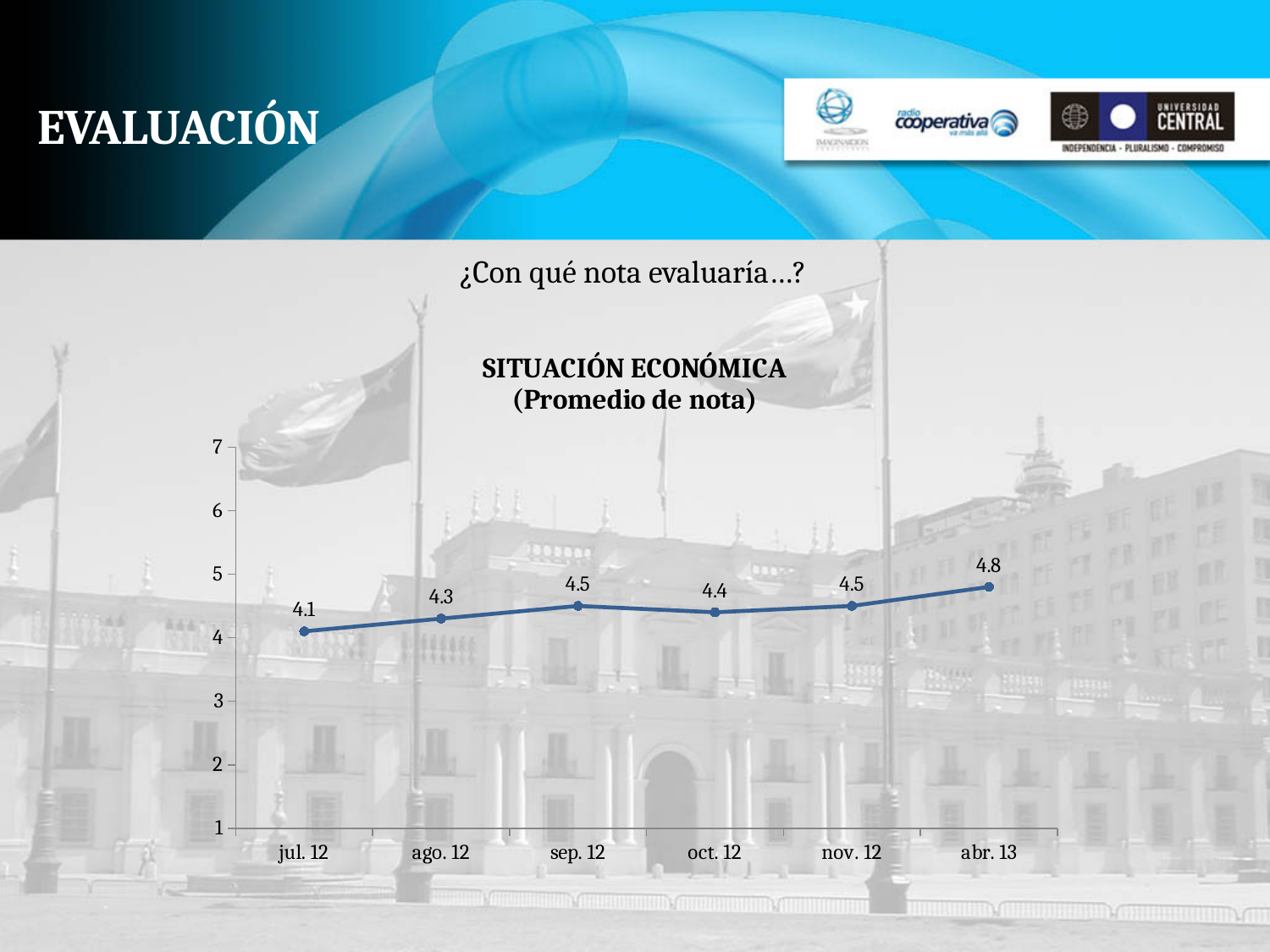
What is the title of the chart? SITUACIÓN ECONÓMICA (Promedio de nota) Which period has the lowest value? jul. 12 How many data points are plotted on the chart? 6 What is the value for abr. 13? 4.8 Is the value for nov. 12 greater or less than 5? less Do the values generally rise or fall from jul. 12 to abr. 13? rise What is the difference between the values for abr. 13 and jul. 12? 0.7 Which is larger, the value for sep. 12 or the value for oct. 12? sep. 12 What is the value for oct. 12? 4.4 Which period has the highest value? abr. 13 What kind of chart is shown? line chart What is the value for jul. 12? 4.1